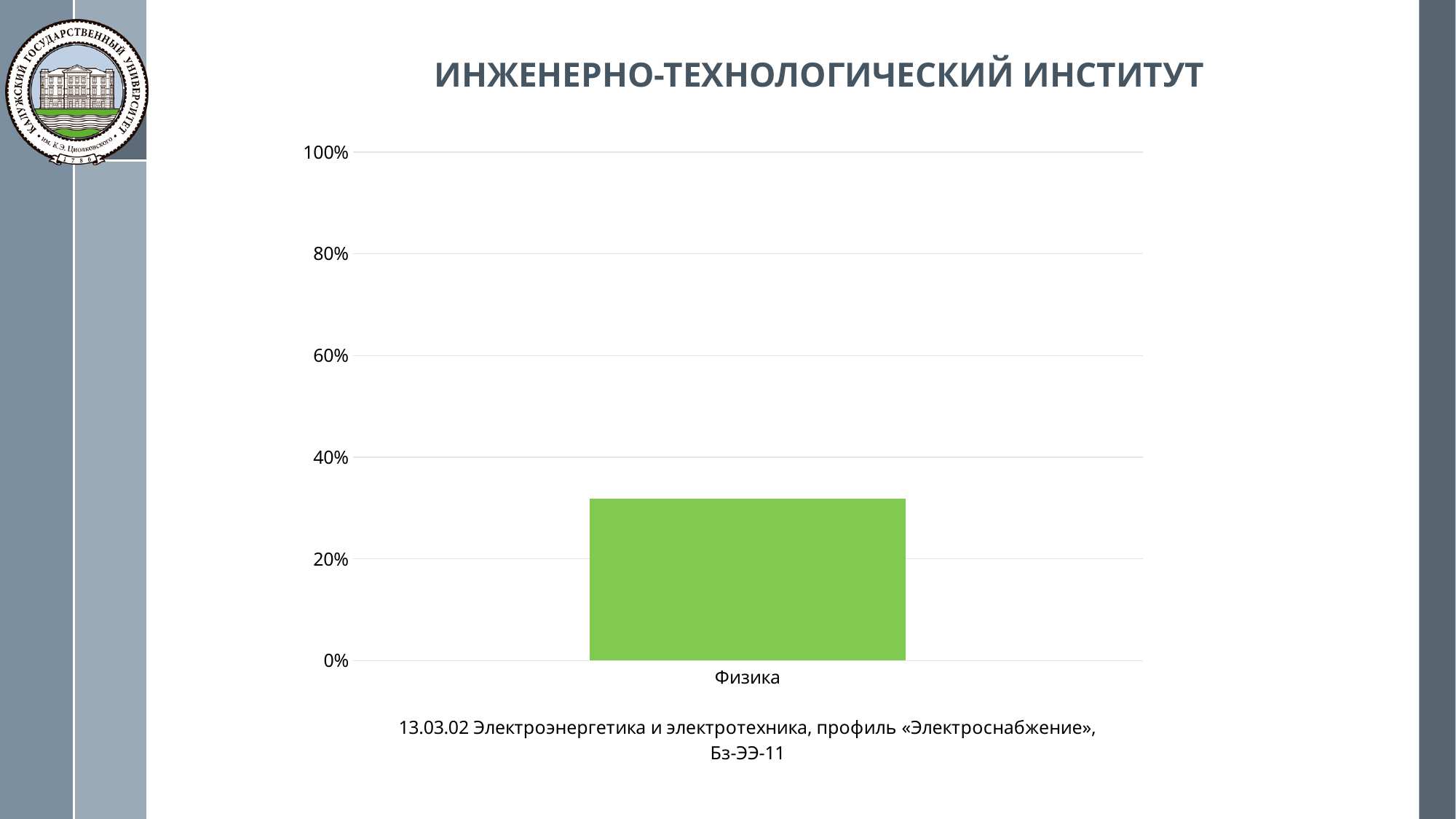
Is the value for Физика greater or less than 60%? less How many bars does the chart contain? 1 Is the value for Физика greater or less than 20%? greater Is the value for Физика greater or less than 40%? less What is the label of the only category on the x axis? Физика What colour is the bar in the chart? green What kind of chart is shown on the slide? bar chart